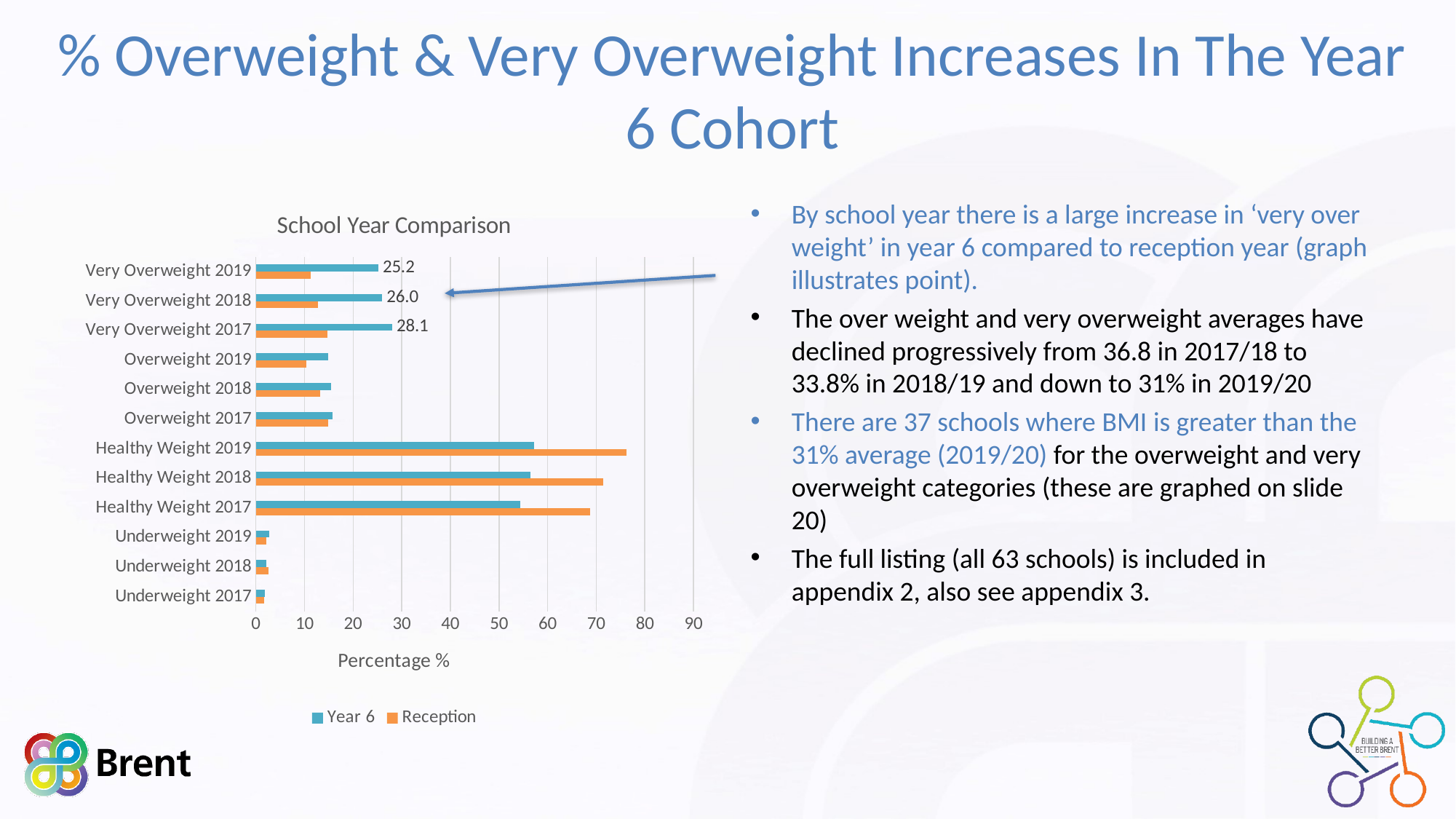
In the School Year Comparison chart, what is the Year 6 value for Very Overweight 2017? 28.1 In the School Year Comparison chart, is the Year 6 value for Underweight 2019 greater or less than 10? less In the School Year Comparison chart, which of the three labelled Very Overweight years has the highest Year 6 value? Very Overweight 2017 What kind of chart is the School Year Comparison chart? Bar chart In the School Year Comparison chart, for Healthy Weight 2019, which series has the larger value, Year 6 or Reception? Reception In the School Year Comparison chart, is the Reception value for Healthy Weight 2019 greater or less than 70? greater In the School Year Comparison chart, what is the difference between the Year 6 Very Overweight values for 2017 and 2019? 2.9 What is the title of the horizontal axis in the School Year Comparison chart? Percentage % In the School Year Comparison chart, what is the Year 6 value for Very Overweight 2019? 25.2 How many series does the legend of the School Year Comparison chart list? 2 How many categories are shown on the vertical axis of the School Year Comparison chart? 12 In the School Year Comparison chart, what is the Year 6 value for Very Overweight 2018? 26.0